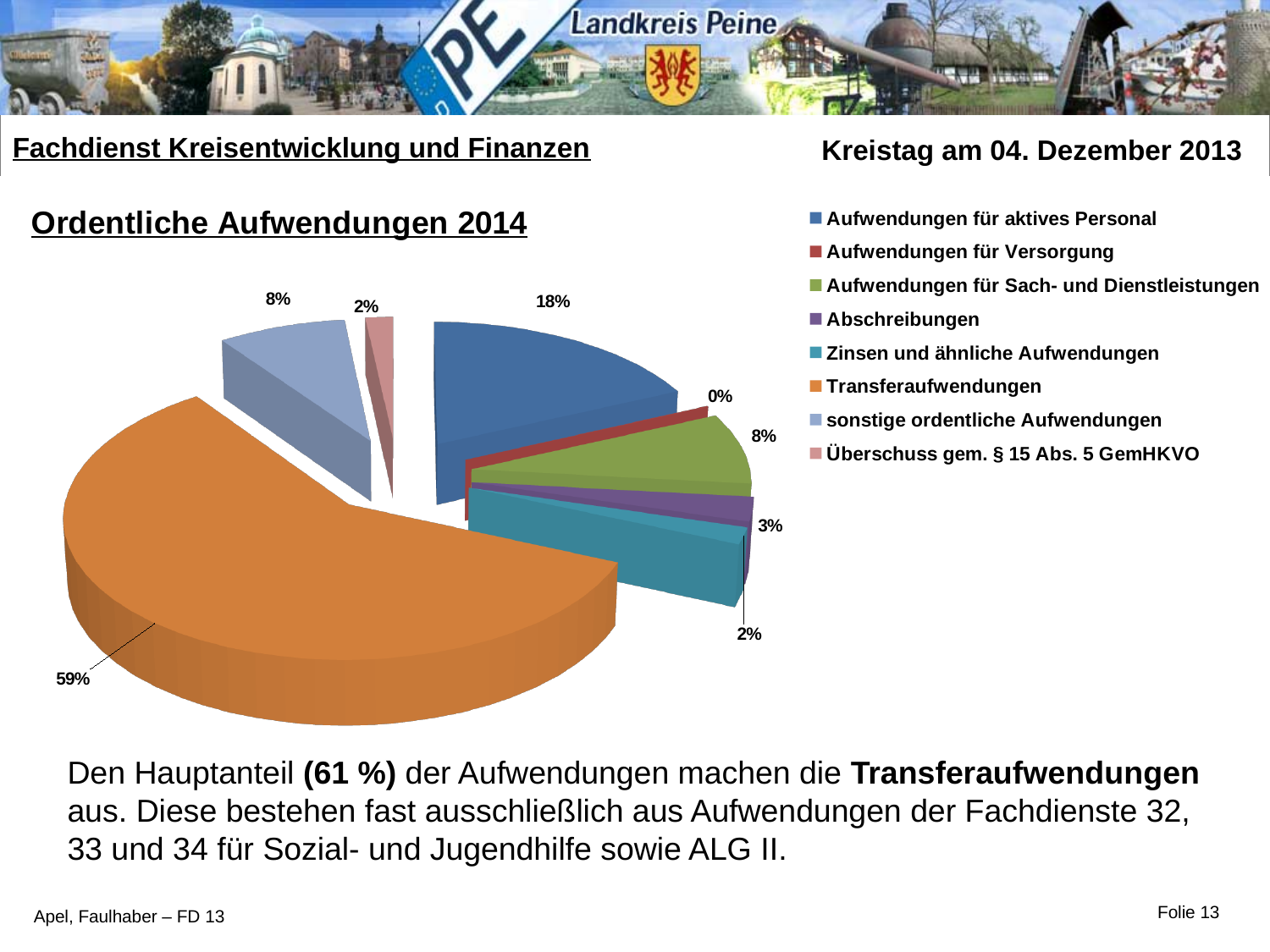
What share of the pie is Aufwendungen für Versorgung? 0% What is the difference in percentage points between Transferaufwendungen and Aufwendungen für aktives Personal? 41 Which category has the largest share of the pie? Transferaufwendungen What share of the pie is Aufwendungen für aktives Personal? 18% What share of the pie is Aufwendungen für Sach- und Dienstleistungen? 8% What kind of chart is shown on the slide? pie chart How many categories does the legend of the pie chart list? 8 Which category has the smallest share of the pie? Aufwendungen für Versorgung What is the title of the chart? Ordentliche Aufwendungen 2014 Which is larger, the share for Abschreibungen or the share for Zinsen und ähnliche Aufwendungen? Abschreibungen